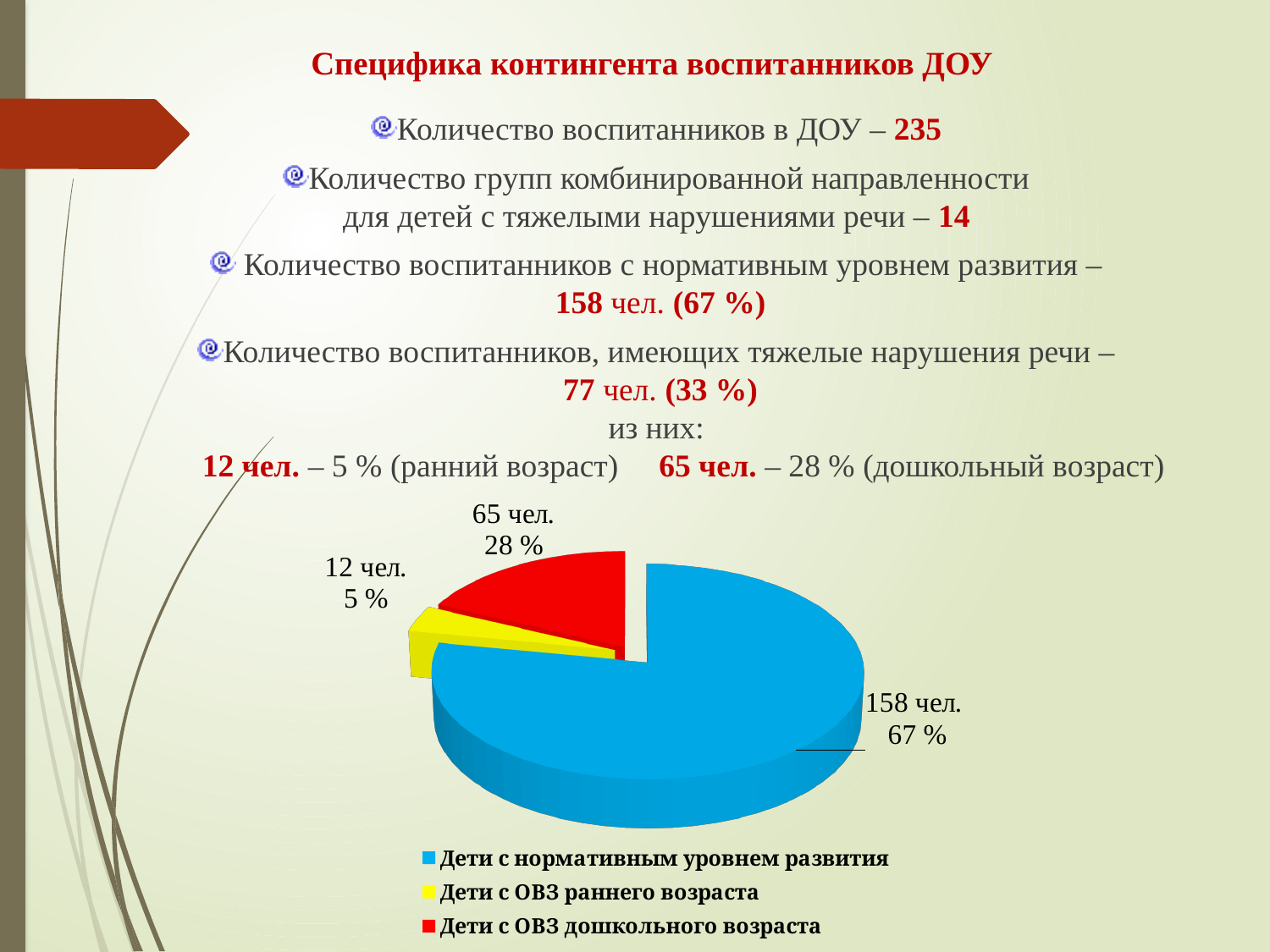
What is the difference in number of children between 'Дети с нормативным уровнем развития' and 'Дети с ОВЗ дошкольного возраста'? 93 чел. What percentage share does the slice 'Дети с ОВЗ раннего возраста' have? 5 % Which slice of the pie chart is the smallest? Дети с ОВЗ раннего возраста How many entries does the legend of the pie chart list? 3 Which slice of the pie chart is the largest? Дети с нормативным уровнем развития What kind of chart is shown on the slide? pie chart How many children are in the slice 'Дети с ОВЗ дошкольного возраста'? 65 чел. How many children are in the slice 'Дети с нормативным уровнем развития'? 158 чел. What percentage share does the slice 'Дети с нормативным уровнем развития' have? 67 % What colour is the slice for 'Дети с ОВЗ дошкольного возраста'? red Which slice is larger: 'Дети с ОВЗ раннего возраста' or 'Дети с ОВЗ дошкольного возраста'? Дети с ОВЗ дошкольного возраста How many slices does the pie chart have? 3